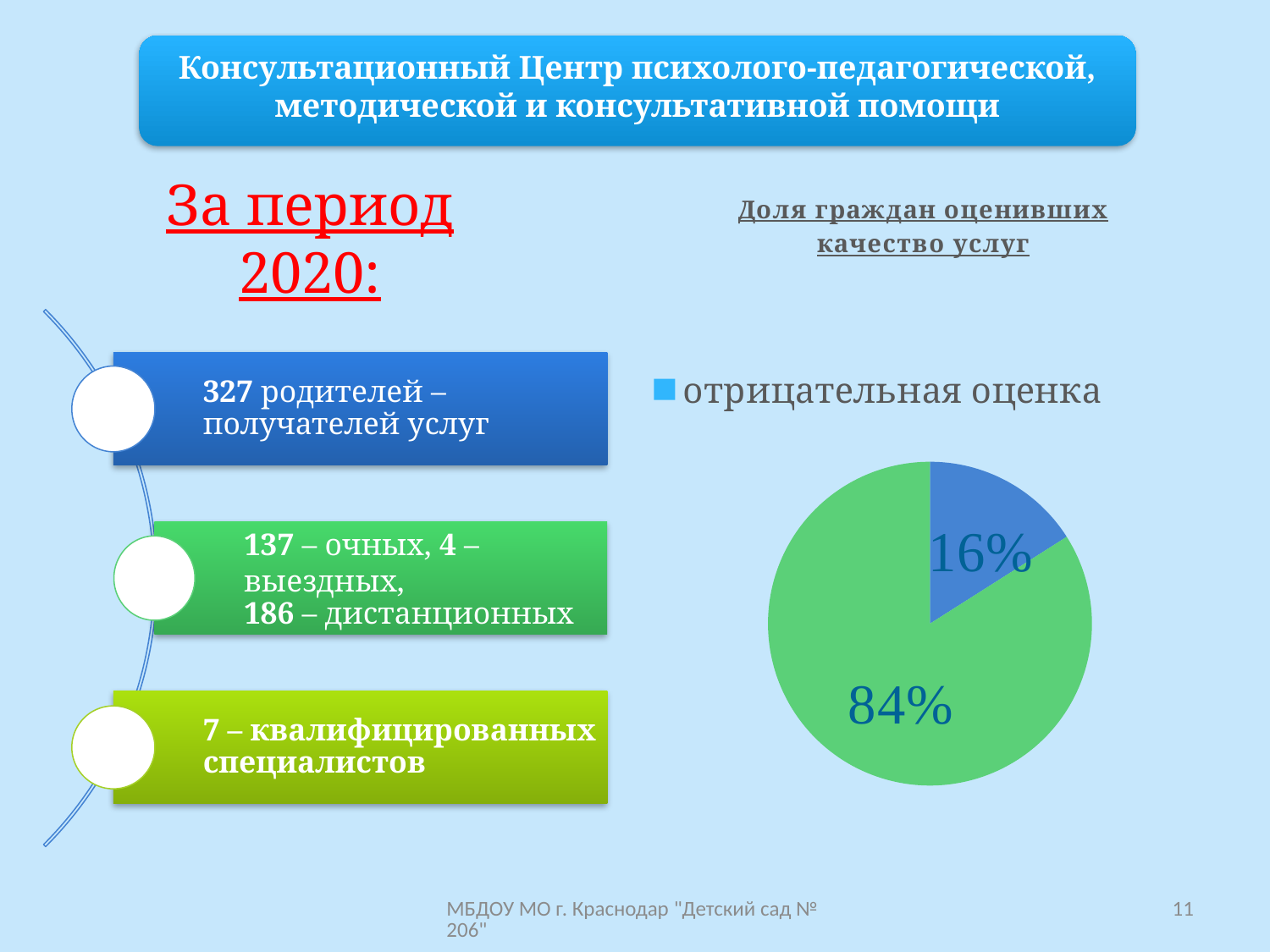
Which slice of the pie chart is larger, the blue one or the green one? the green one How many slices does the pie chart have? 2 What kind of chart is shown on the slide? pie chart What is the legend entry shown above the pie chart? отрицательная оценка What do the two percentages on the pie chart add up to? 100% What is the largest value shown on the pie chart? 84% What percentage is shown on the green slice of the pie chart? 84% How many entries does the pie chart's legend list? 1 What is the smallest value shown on the pie chart? 16% What is the title of the pie chart? Доля граждан оценивших качество услуг